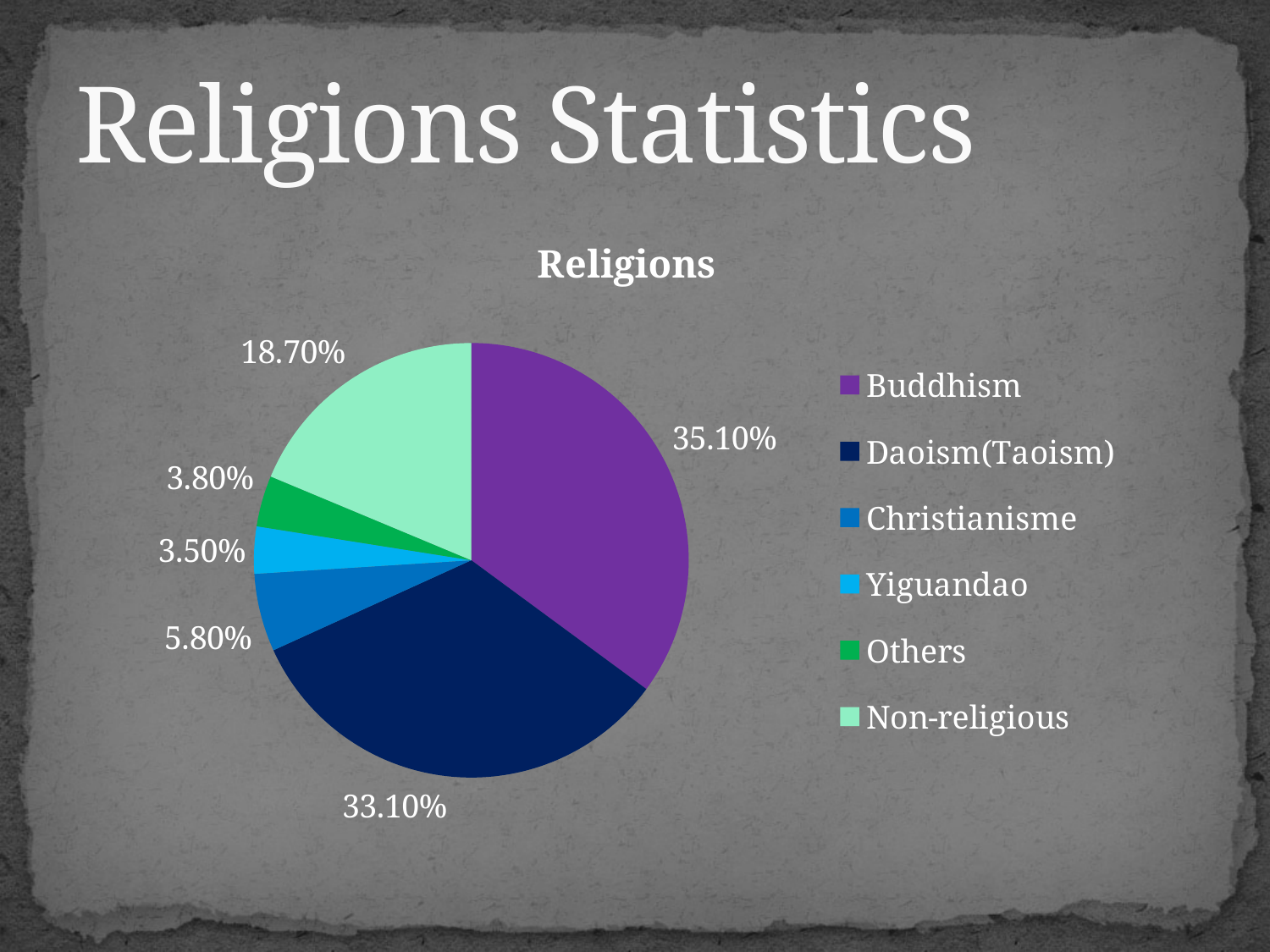
What percentage of the pie is Buddhism? 35.10% Which has a larger share, Others or Christianisme? Christianisme Which category has the largest share of the pie? Buddhism What is the difference in percentage points between Buddhism and Daoism(Taoism)? 2.00% What percentage of the pie is Daoism(Taoism)? 33.10% What is the title of the chart? Religions How many categories does the legend list? 6 What percentage of the pie is Non-religious? 18.70% What percentage of the pie is Yiguandao? 3.50% What percentage of the pie is Christianisme? 5.80% Which category has the smallest share of the pie? Yiguandao What type of chart is shown on the slide? pie chart